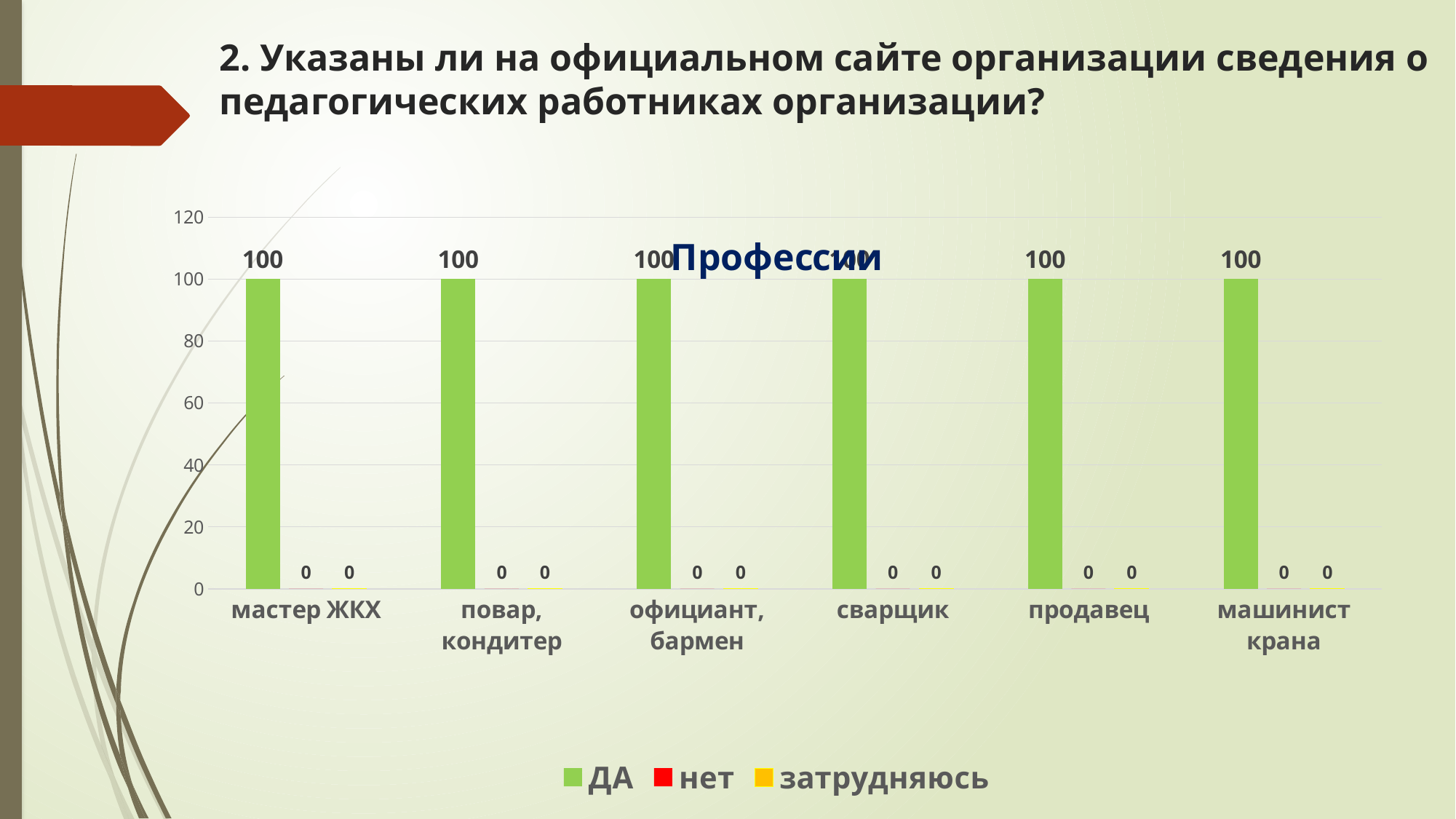
What is the value for ДА for машинист крана? 100 What is the value for ДА for сварщик? 100 How many series does the legend list? 3 How many categories are shown on the x axis? 6 Is the ДА value for продавец greater or less than 80? greater What is the value for затрудняюсь for продавец? 0 What is the difference between the ДА value and the нет value for повар, кондитер? 100 What is the title of the chart? Профессии What is the value for нет for мастер ЖКХ? 0 Which is larger for официант, бармен: the ДА value or the затрудняюсь value? ДА Which colour represents the ДА series in the legend? green What kind of chart is shown on the slide? bar chart